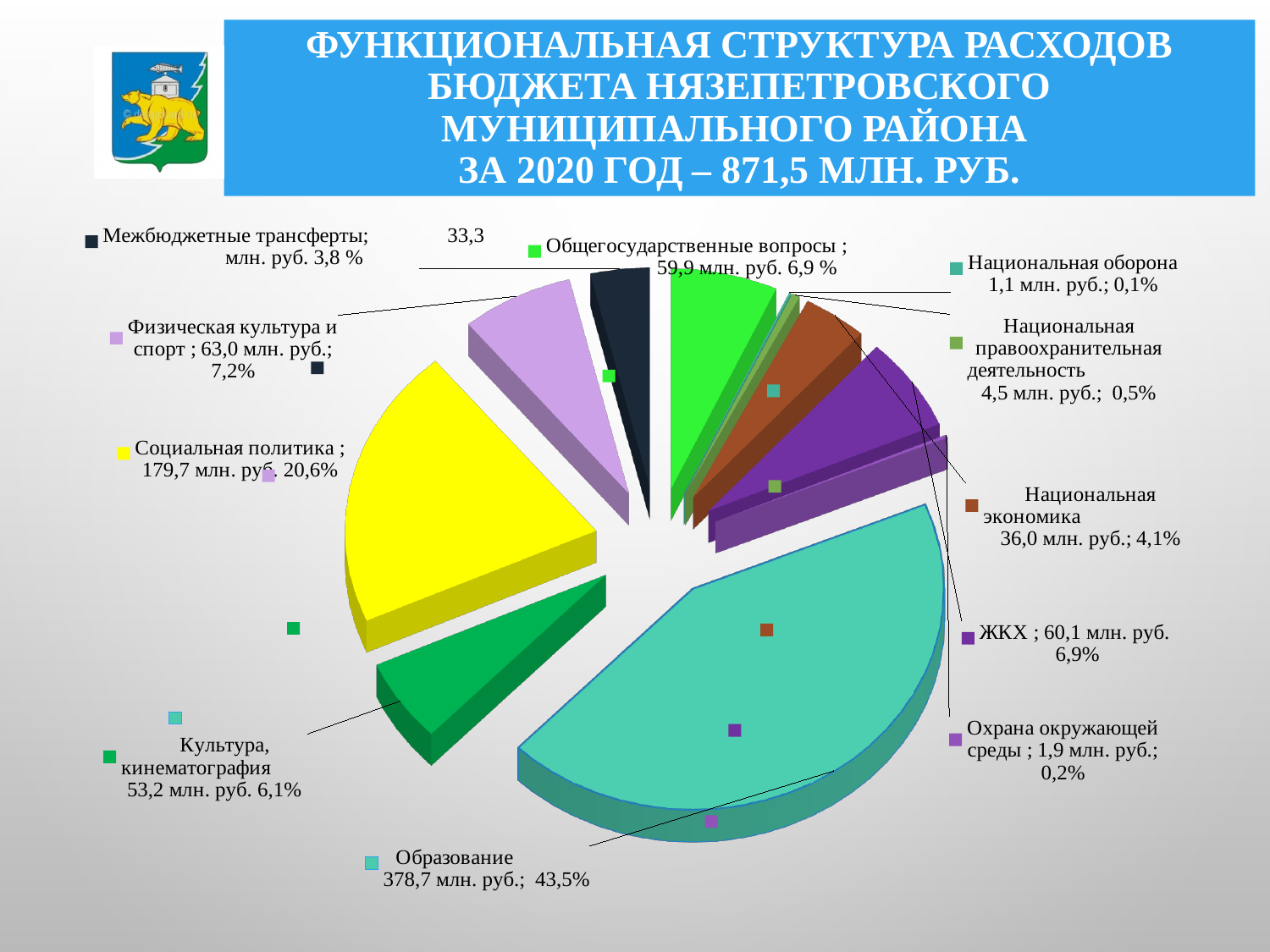
Which category has the largest share of the budget expenditures? Образование Which category has the smallest share of the budget expenditures? Национальная оборона What is the value for Охрана окружающей среды in million rubles? 1,9 млн. руб. What total budget expenditure for 2020 is stated in the chart title? 871,5 млн. руб. What kind of chart is shown on the slide? Pie chart What percentage share is shown for Физическая культура и спорт? 7,2% How many categories (slices) does the pie chart show? 11 What is the value for Социальная политика in million rubles? 179,7 млн. руб. What is the difference in million rubles between Образование (378,7) and Социальная политика (179,7)? 199,0 млн. руб. Which is larger: the value for ЖКХ or the value for Культура, кинематография? ЖКХ What share of the pie does Образование represent? 43,5% What is the value for Национальная экономика in million rubles? 36,0 млн. руб.